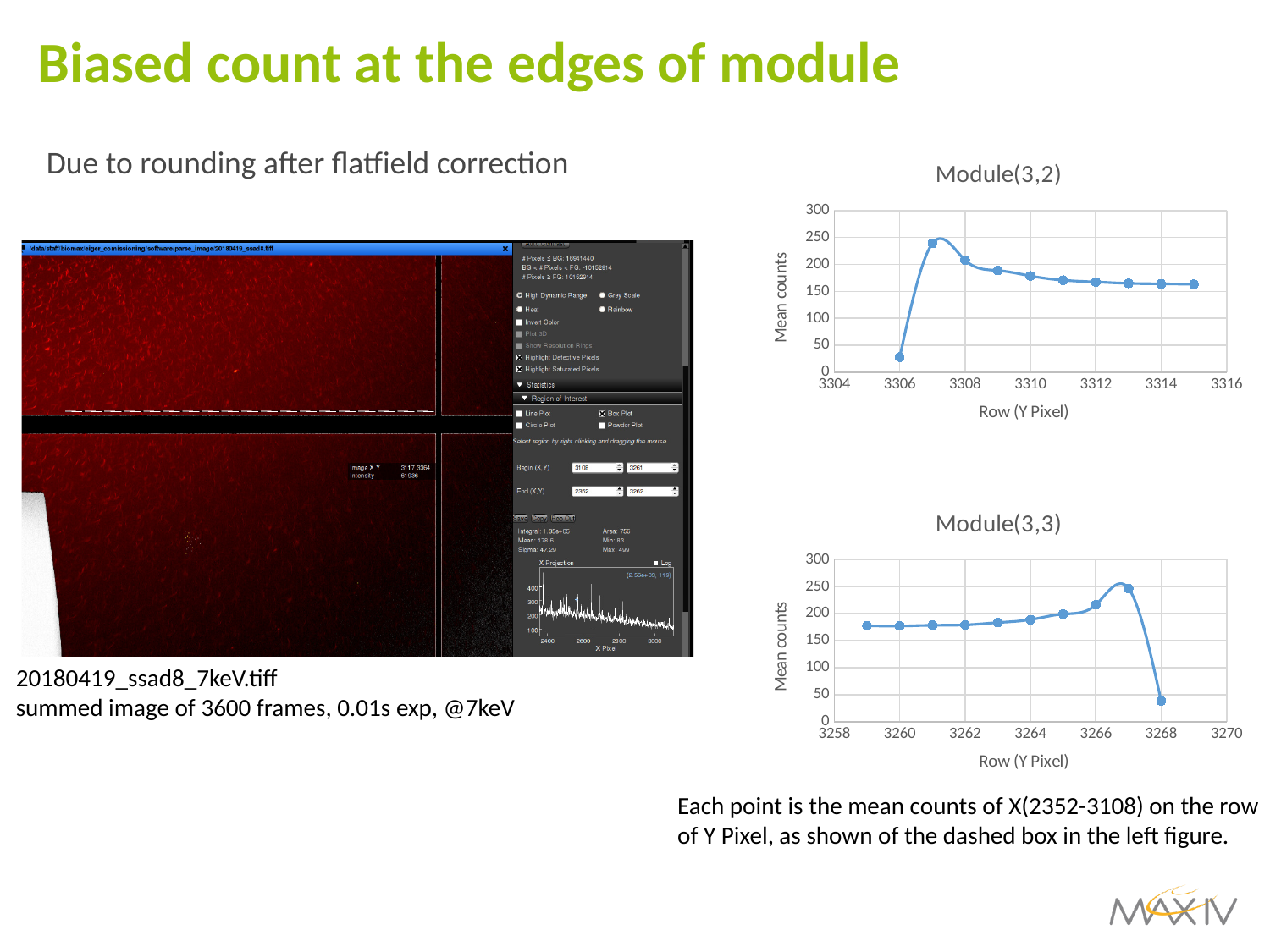
In the Module(3,3) chart, which has higher mean counts: row 3260 or row 3266? 3266 In the Module(3,3) chart, is the mean counts value at row 3264 greater or less than 200? less What kind of chart is the Module(3,2) chart? line chart What is the y-axis label of the Module(3,3) chart? Mean counts In the Module(3,3) chart, do the mean counts rise or fall from row 3259 to row 3266? rise In the Module(3,2) chart, which row (Y Pixel) has the lowest mean counts? 3306 In the Module(3,3) chart, is the mean counts value at row 3268 greater or less than 50? less In the Module(3,3) chart, which row (Y Pixel) has the lowest mean counts? 3268 In the Module(3,2) chart, do the mean counts rise or fall from row 3308 to row 3315? fall In the Module(3,2) chart, is the mean counts value at row 3315 greater or less than 150? greater